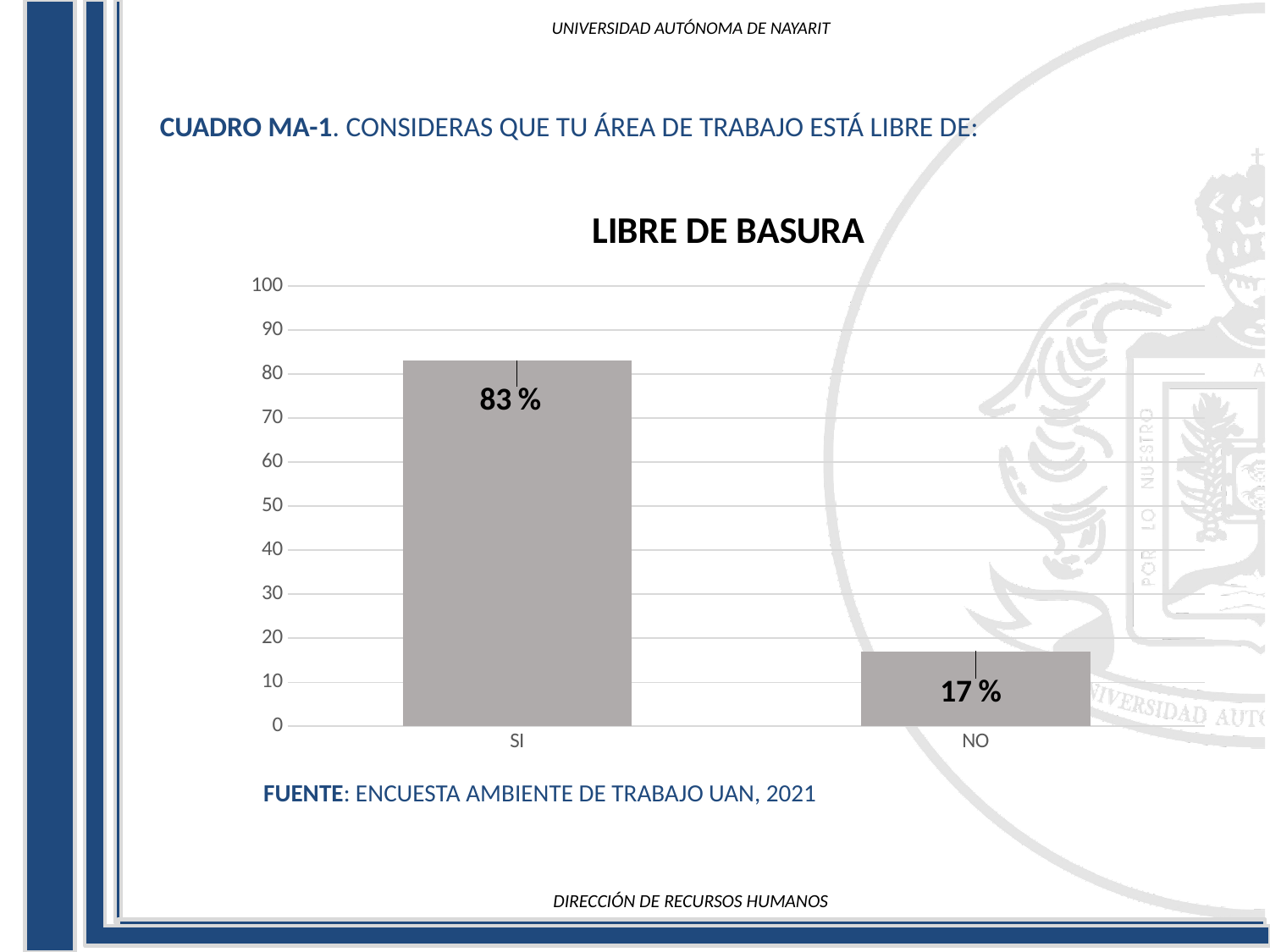
What is the highest value shown on the y axis? 100 Is the value for SI greater or less than 80? greater Is the value for NO greater or less than 20? less What is the difference between the values for SI and NO? 66 % Which is larger, the value for SI or the value for NO? SI What is the value for NO? 17 % What is the title of the chart? LIBRE DE BASURA What is the value for SI? 83 % Which category has the highest value? SI What kind of chart is shown? bar chart How many categories are shown on the x axis? 2 Which category has the lowest value? NO